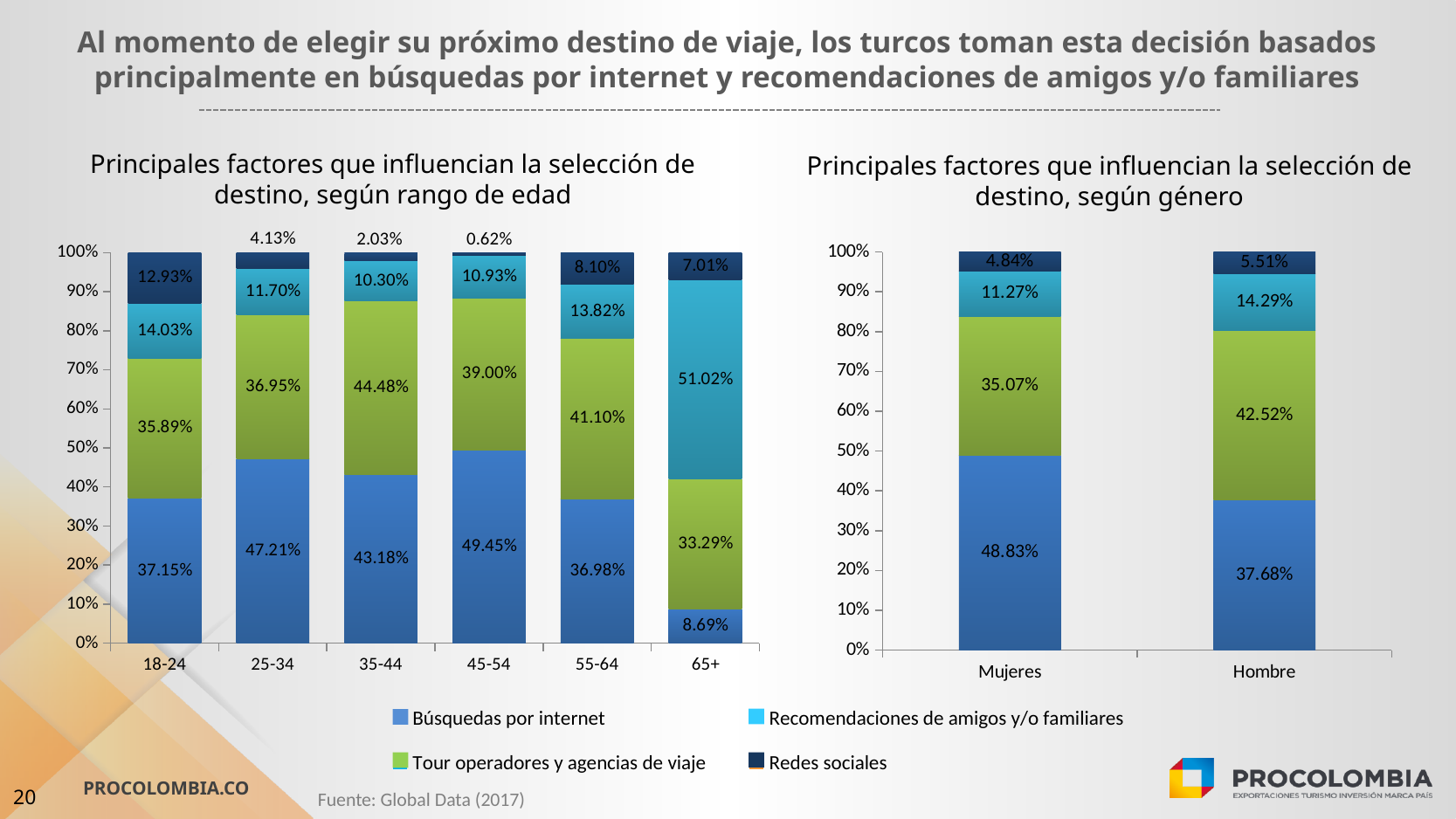
In the chart 'según género', which is larger, the Búsquedas por internet value for Mujeres or for Hombre? Mujeres In the chart 'Principales factores que influencian la selección de destino, según rango de edad', what is the value for Búsquedas por internet in the 18-24 age group? 37.15% In the chart 'según rango de edad', how many age groups are shown on the x axis? 6 In the chart 'según género', what is the value for Redes sociales for Mujeres? 4.84% In the chart 'según rango de edad', what is the value for Redes sociales in the 45-54 age group? 0.62% In the chart 'según rango de edad', which age group has the lowest value for Búsquedas por internet? 65+ In the chart 'según rango de edad', which age group has the highest value for Búsquedas por internet? 45-54 How many series does the shared legend list for the charts on the slide? 4